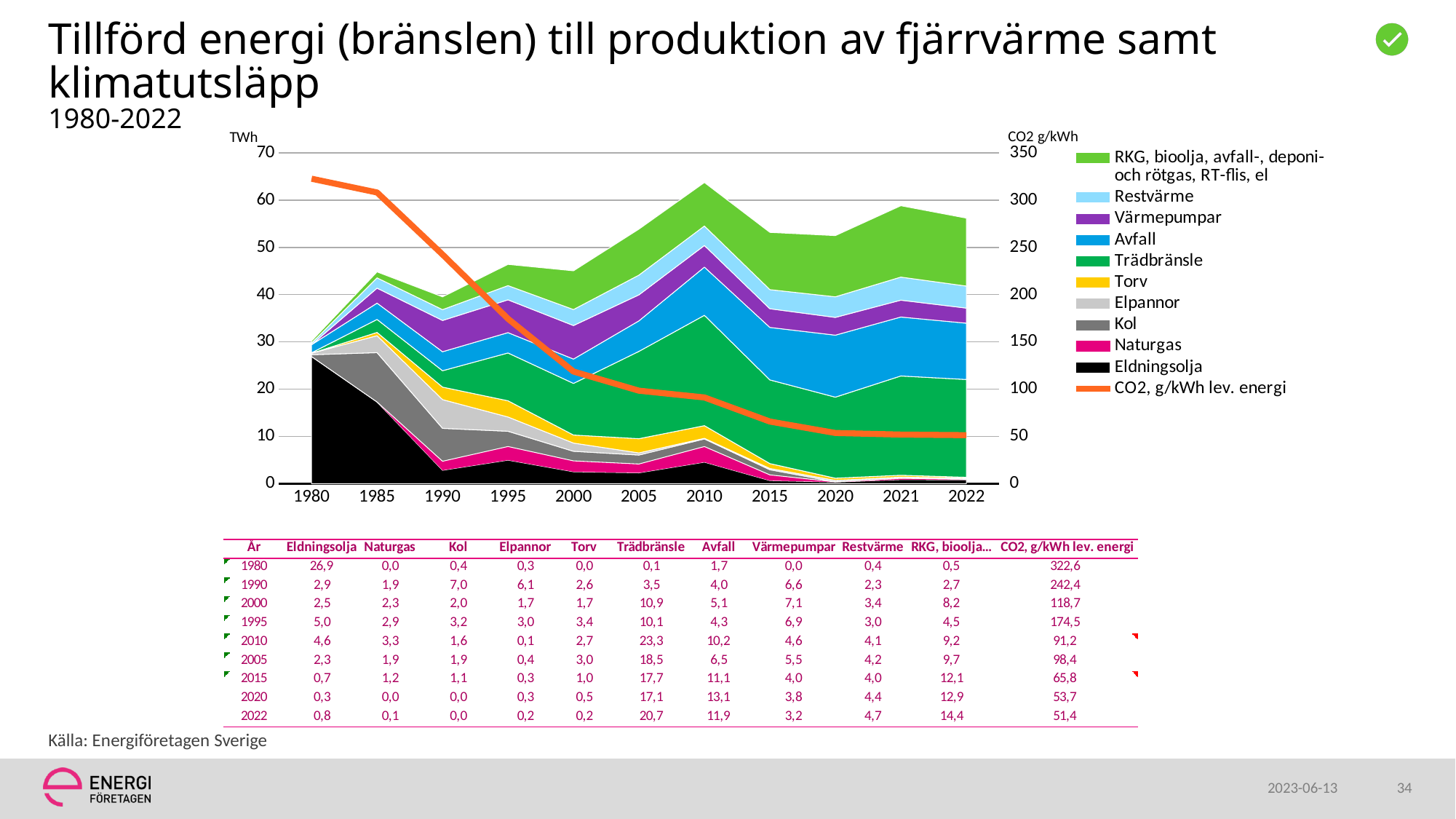
Which is larger in 2015, Avfall or Trädbränsle? Trädbränsle What type of chart is shown on the slide? Stacked area chart with a line Which fuel has the highest value in 1980? Eldningsolja What is the value of Trädbränsle in 2010? 23,3 What is the difference between the CO2 value in 1980 and in 2022? 271,2 What unit is shown on the left axis of the chart? TWh Does the CO2 g/kWh line rise or fall from 1980 to 2022? Fall What is the value of Eldningsolja in 1980 according to the table? 26,9 What is the CO2 value (g/kWh lev. energi) for 2022? 51,4 How many series does the chart legend list? 11 In which year is the CO2 g/kWh lev. energi value highest? 1980 How many years are shown along the x axis of the chart? 11